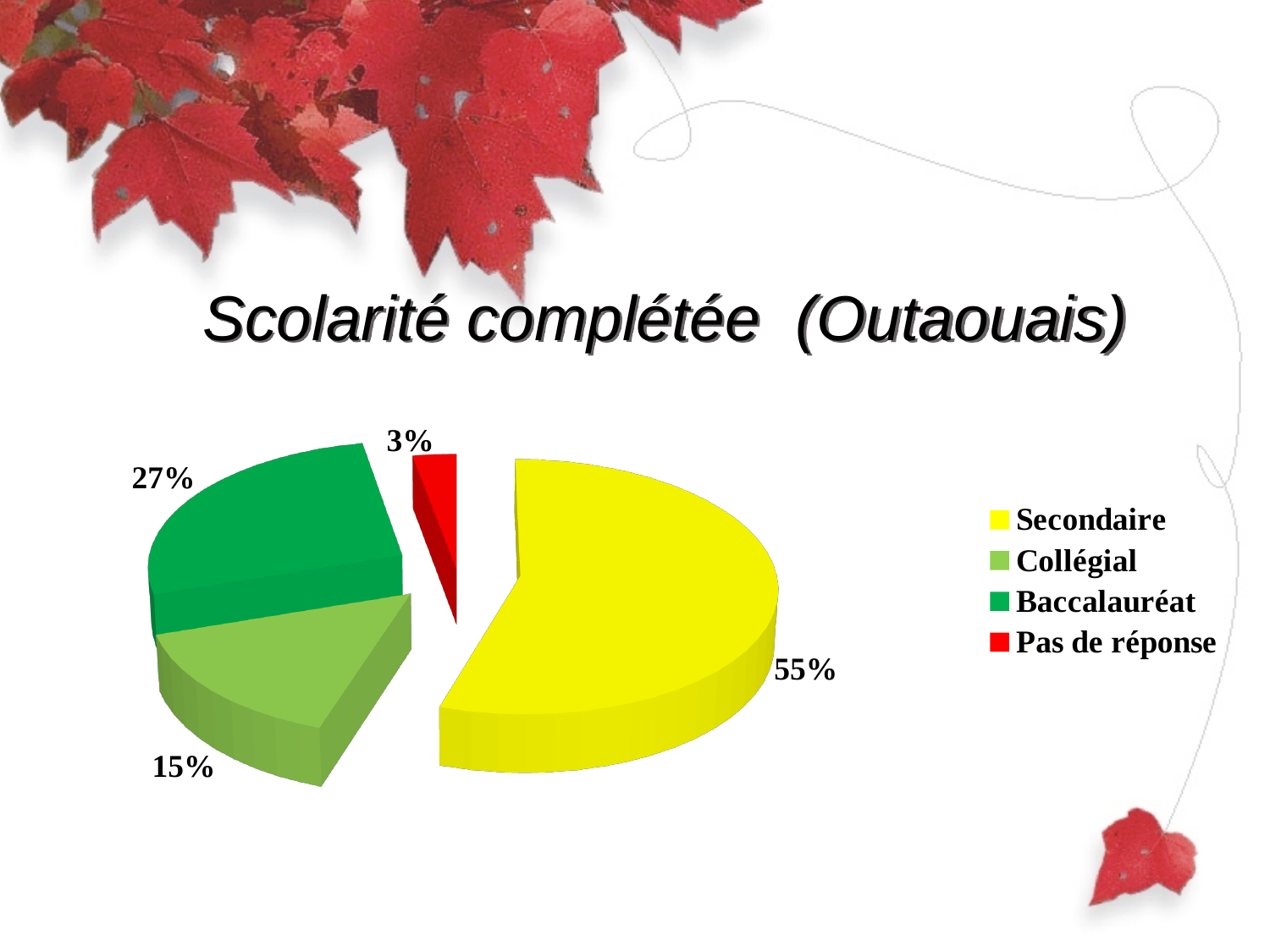
Which category has the smallest slice of the pie? Pas de réponse What share of the pie does Secondaire represent? 55% Which is larger, the share for Collégial or the share for Baccalauréat? Baccalauréat What share of the pie does Pas de réponse represent? 3% Which category has the largest slice of the pie? Secondaire What kind of chart is shown on the slide? Pie chart What share of the pie does Baccalauréat represent? 27% What is the difference in percentage points between Secondaire and Baccalauréat? 28 How many categories does the pie chart show? 4 What is the difference in percentage points between Baccalauréat and Collégial? 12 What is the title of the chart? Scolarité complétée (Outaouais)